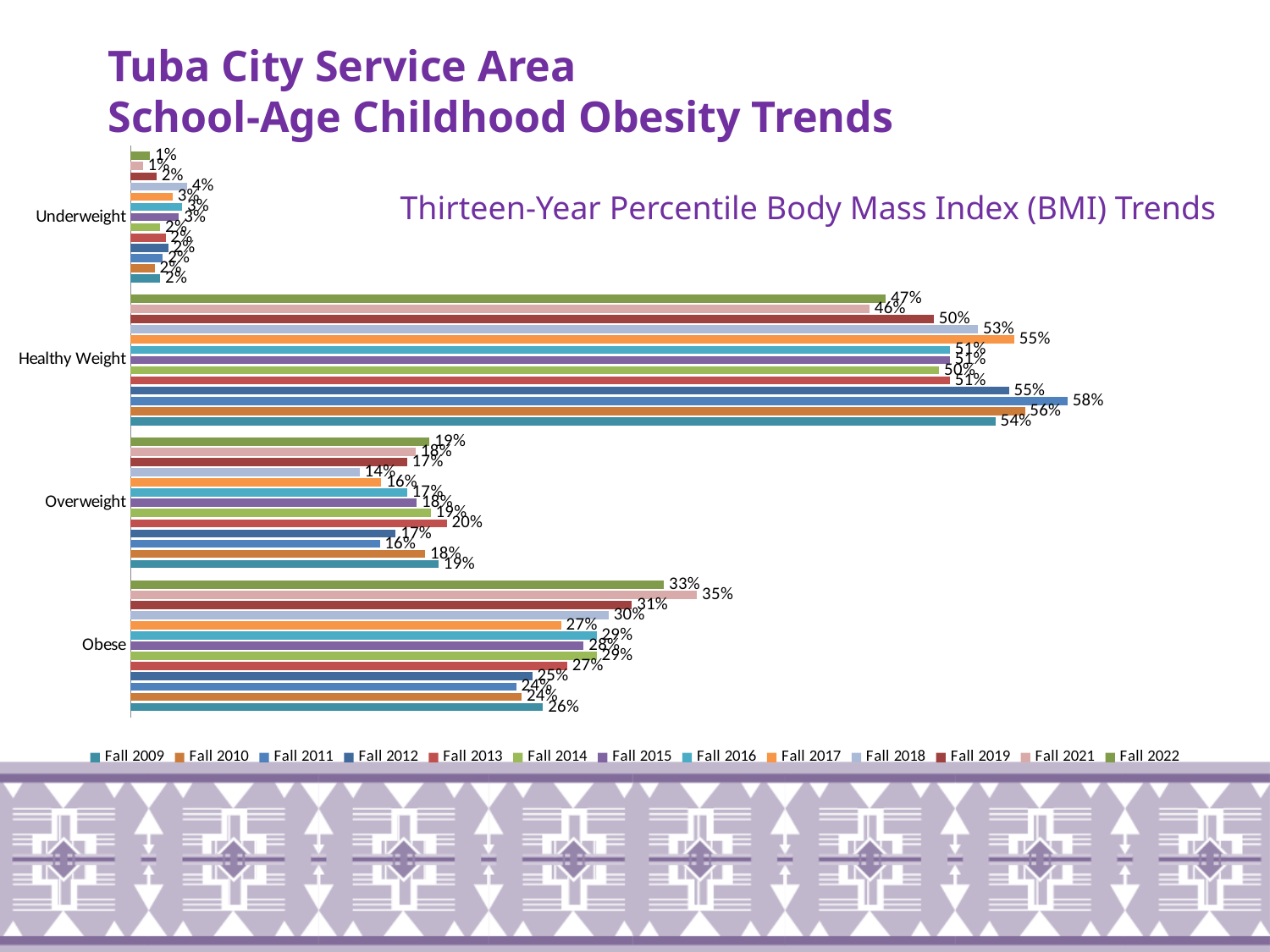
Which is larger, the Obese value for Fall 2022 or for Fall 2009? Fall 2022 Which series has the lowest Overweight value? Fall 2018 What is the Healthy Weight value for Fall 2021? 46% What is the Healthy Weight value for Fall 2011? 58% What is the difference between the Healthy Weight values for Fall 2011 and Fall 2021? 12 percentage points What kind of chart is shown on the slide? Bar chart How many series does the legend list? 13 Which series has the highest Healthy Weight value? Fall 2011 What is the Overweight value for Fall 2018? 14% What is the title of the chart? Thirteen-Year Percentile Body Mass Index (BMI) Trends What is the Obese value for Fall 2021? 35% How many weight categories are plotted on the chart? 4